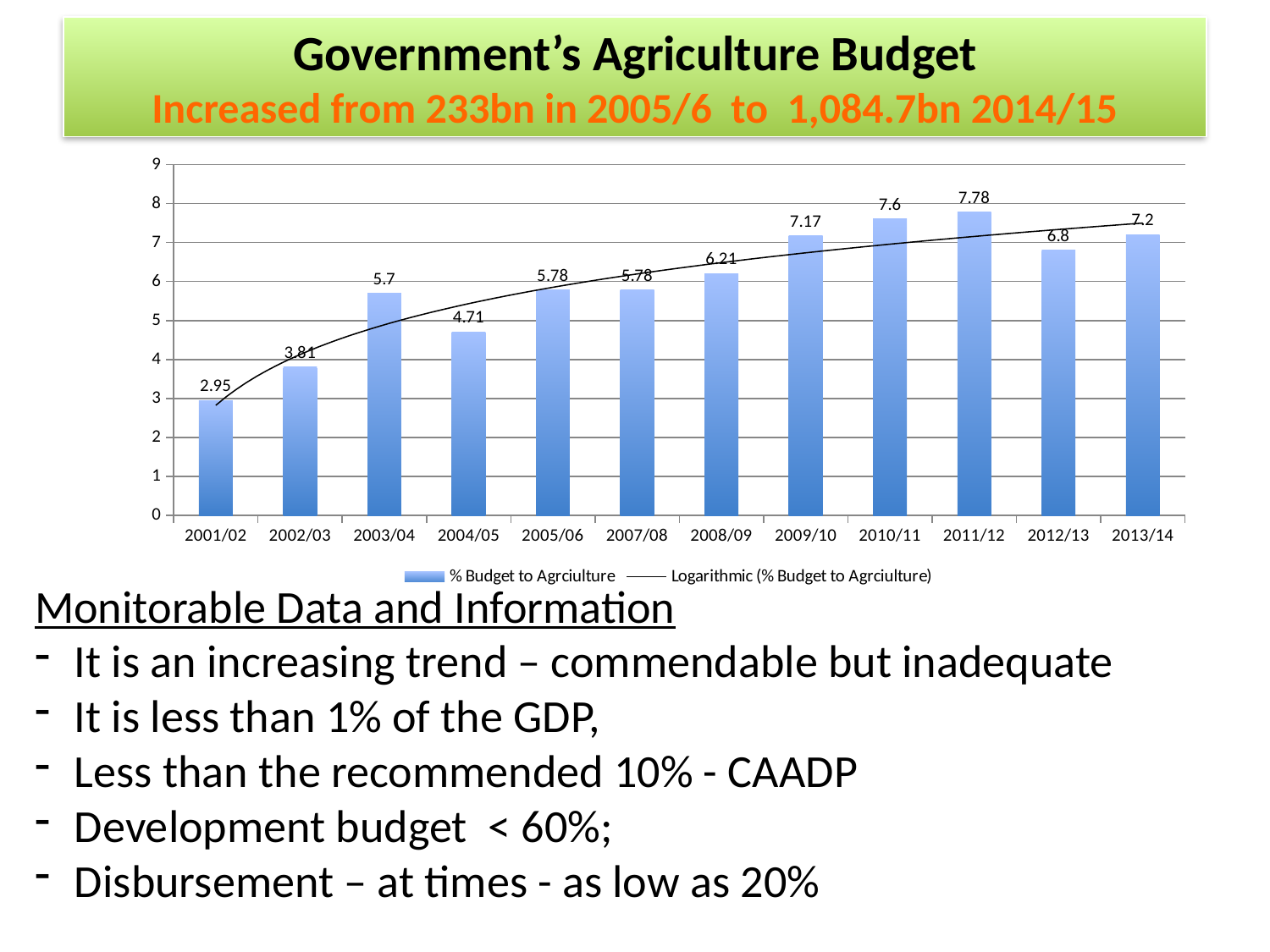
What is the % Budget to Agriculture value for 2009/10? 7.17 Which year has the lowest % Budget to Agriculture? 2001/02 Which is larger, the value for 2003/04 or the value for 2004/05? 2003/04 Which year has the highest % Budget to Agriculture? 2011/12 Is the value for 2008/09 greater or less than 6? greater What is the difference between the values for 2011/12 and 2001/02? 4.83 What is the % Budget to Agriculture value for 2001/02? 2.95 What kind of chart is used to show the % Budget to Agriculture? Bar chart How many entries does the legend list? 2 What is the difference between the values for 2010/11 and 2012/13? 0.8 What is the value shown for 2012/13? 6.8 How many years are shown on the x axis? 12